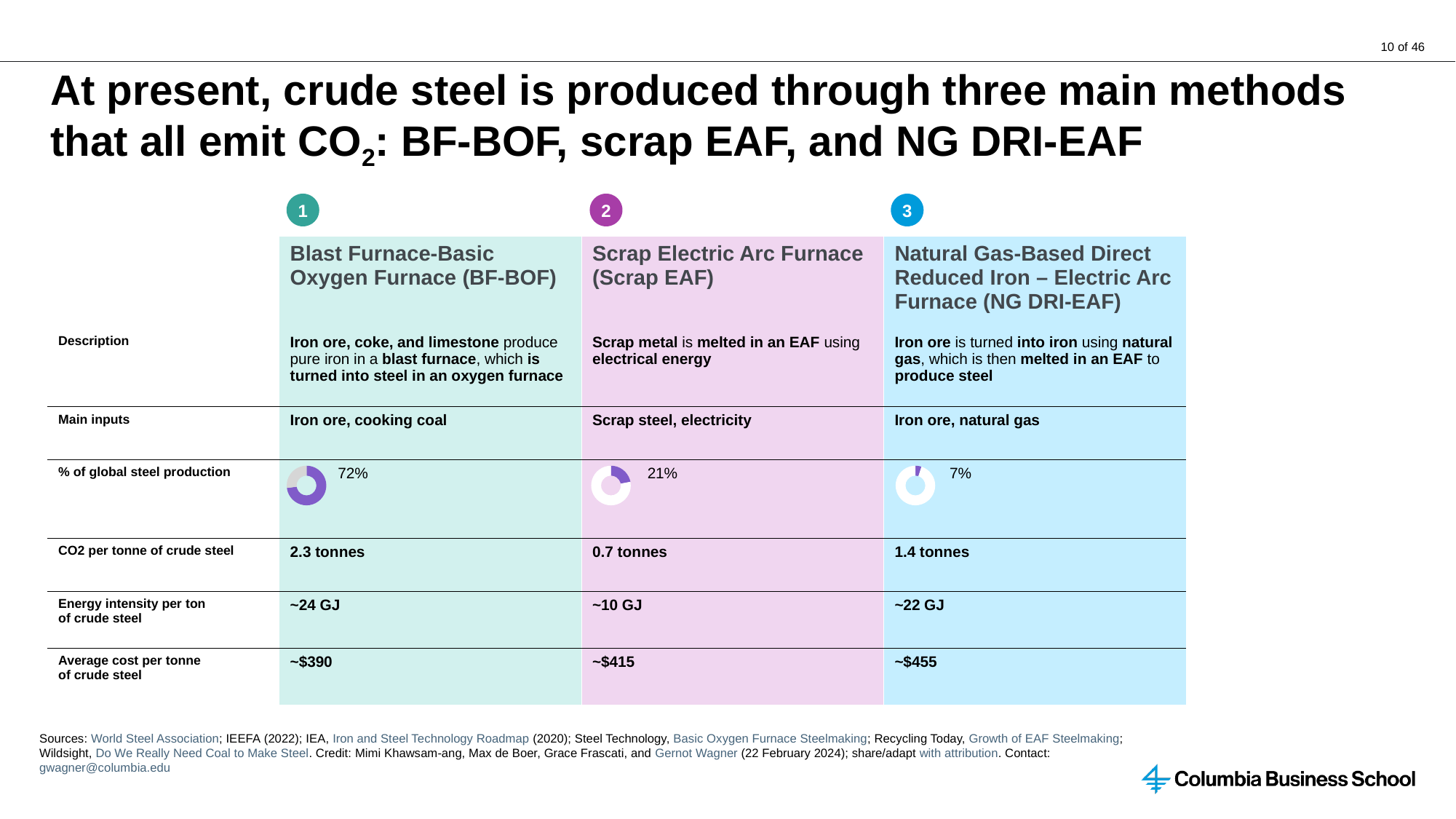
What type of chart is used in the '% of global steel production' row to show each method's share? Donut (pie) chart What colour is the filled segment in the donut charts in the '% of global steel production' row? Purple Among the three donut charts in the '% of global steel production' row, which production method has the smallest share? Natural Gas-Based Direct Reduced Iron – Electric Arc Furnace (NG DRI-EAF) In the '% of global steel production' row, which has a larger share of global steel production: Scrap EAF or NG DRI-EAF? Scrap EAF In the '% of global steel production' row, is the BF-BOF share greater or less than 50%? greater In the '% of global steel production' row, what is the difference in percentage points between the BF-BOF share and the Scrap EAF share? 51 percentage points In the '% of global steel production' row, what share of global steel production does the BF-BOF donut chart show? 72% In the '% of global steel production' row, what is the difference in percentage points between the Scrap EAF share and the NG DRI-EAF share? 14 percentage points How many donut charts appear in the '% of global steel production' row? 3 Among the three donut charts in the '% of global steel production' row, which production method has the largest share? Blast Furnace-Basic Oxygen Furnace (BF-BOF) In the '% of global steel production' row, what share of global steel production does the Scrap EAF donut chart show? 21% In the '% of global steel production' row, what share of global steel production does the NG DRI-EAF donut chart show? 7%